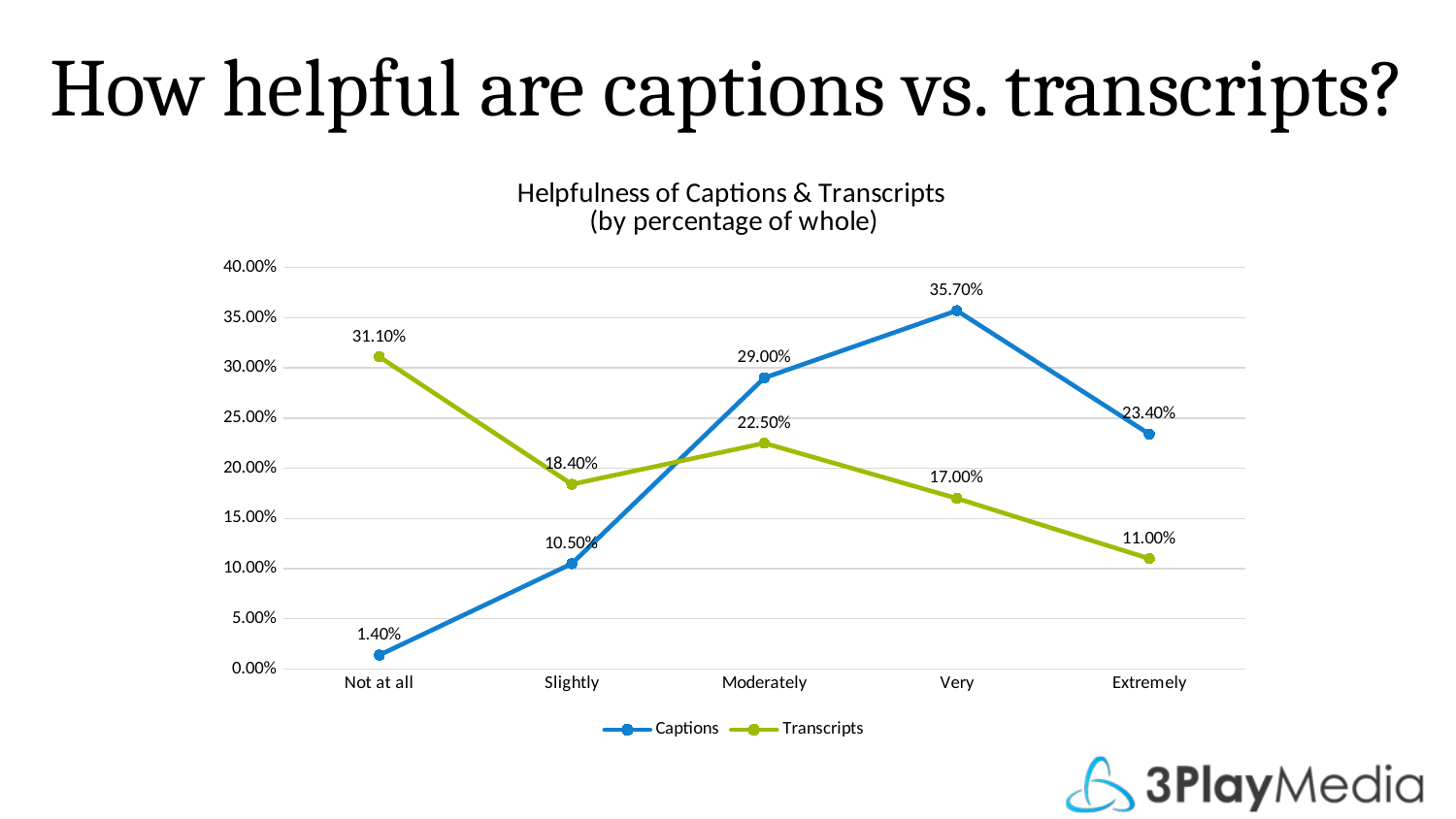
Does the Transcripts line generally rise or fall from Not at all to Extremely? Fall What is the Captions value for Very? 35.70% What is the difference between the Captions and Transcripts values for Moderately? 6.50% What is the Captions value for Slightly? 10.50% What is the Transcripts value for Not at all? 31.10% Which category has the highest Captions value? Very How many categories are shown on the x axis? 5 What is the Transcripts value for Extremely? 11.00% What kind of chart is shown? Line chart How many series does the legend list? 2 Which category has the lowest Transcripts value? Extremely For Slightly, which series has the larger value, Captions or Transcripts? Transcripts